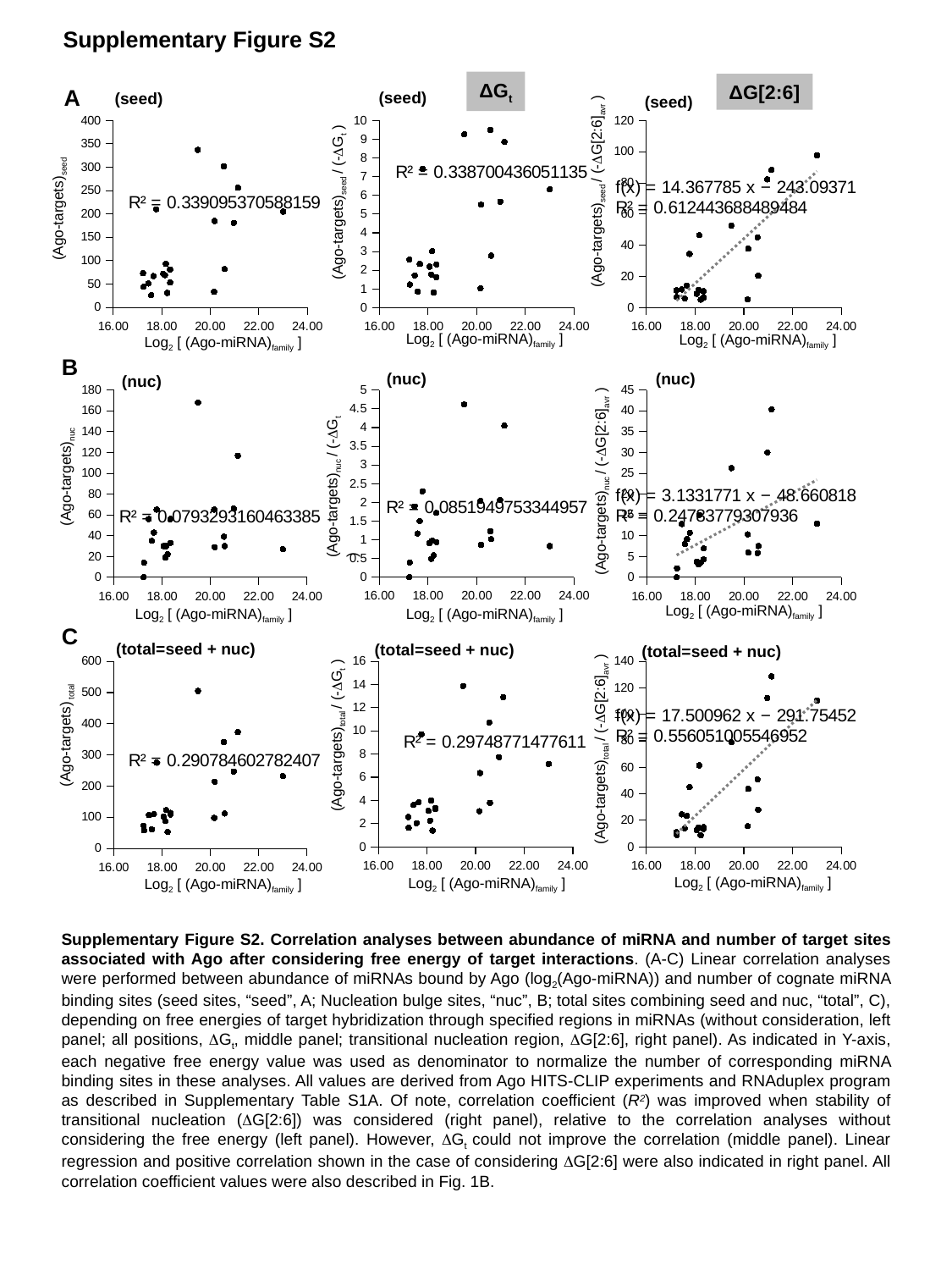
How many charts are shown on the slide in total? 9 In the top-left (seed) chart of panel A, what R² value is printed? R² = 0.339095370588159 In the bottom-left (total=seed + nuc) chart of panel C, is the highest plotted point greater or less than 400 on the y axis? greater What is the x-axis label shared by all the charts on the slide? Log2 [ (Ago-miRNA)family ] In the top-right (seed) ΔG[2:6] chart of panel A, what R² value is printed? R² = 0.612443688489484 In the bottom-right (total=seed + nuc) ΔG[2:6] chart of panel C, what regression equation is printed? f(x) = 17.500962 x − 291.75452 In the middle-centre (nuc) ΔGt chart of panel B, what R² value is printed? R² = 0.0851949753344957 What kind of chart is the top-left chart labelled (seed) in panel A? scatter plot In the top-left (seed) chart of panel A, is the highest plotted point greater or less than 300 on the y axis? greater In the bottom-left (total=seed + nuc) chart of panel C, what R² value is printed? R² = 0.290784602782407 In the top-right (seed) ΔG[2:6] chart of panel A, what regression equation is printed? f(x) = 14.367785 x − 243.09371 In the middle-right (nuc) ΔG[2:6] chart of panel B, is the highest plotted point greater or less than 35 on the y axis? greater